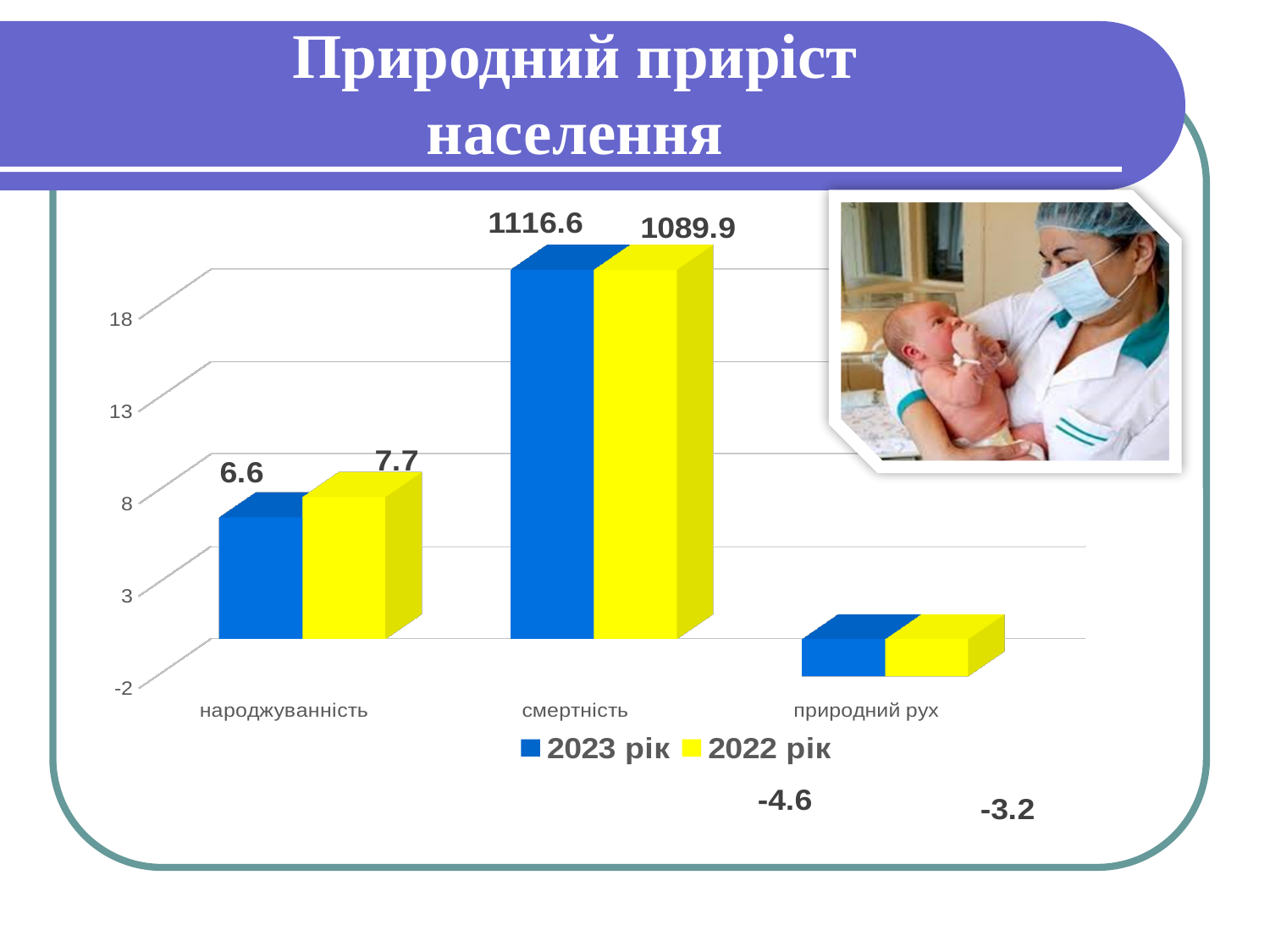
Which category has the lowest values in the chart? природний рух What is the value for народжуваність in the 2022 рік series? 7.7 What is the difference between the 2022 рік and 2023 рік values for народжуваність? 1.1 Which category has the highest values in the chart? смертність What is the value for природний рух in the 2023 рік series? -4.6 What value is printed above the 2023 рік bar for смертність? 1116.6 What is the value for природний рух in the 2022 рік series? -3.2 How many series does the legend list? 2 What is the value for народжуваність in the 2023 рік series? 6.6 How many categories are shown on the x axis? 3 For народжуваність, which series has the larger value, 2023 рік or 2022 рік? 2022 рік What kind of chart is shown on the slide? bar chart